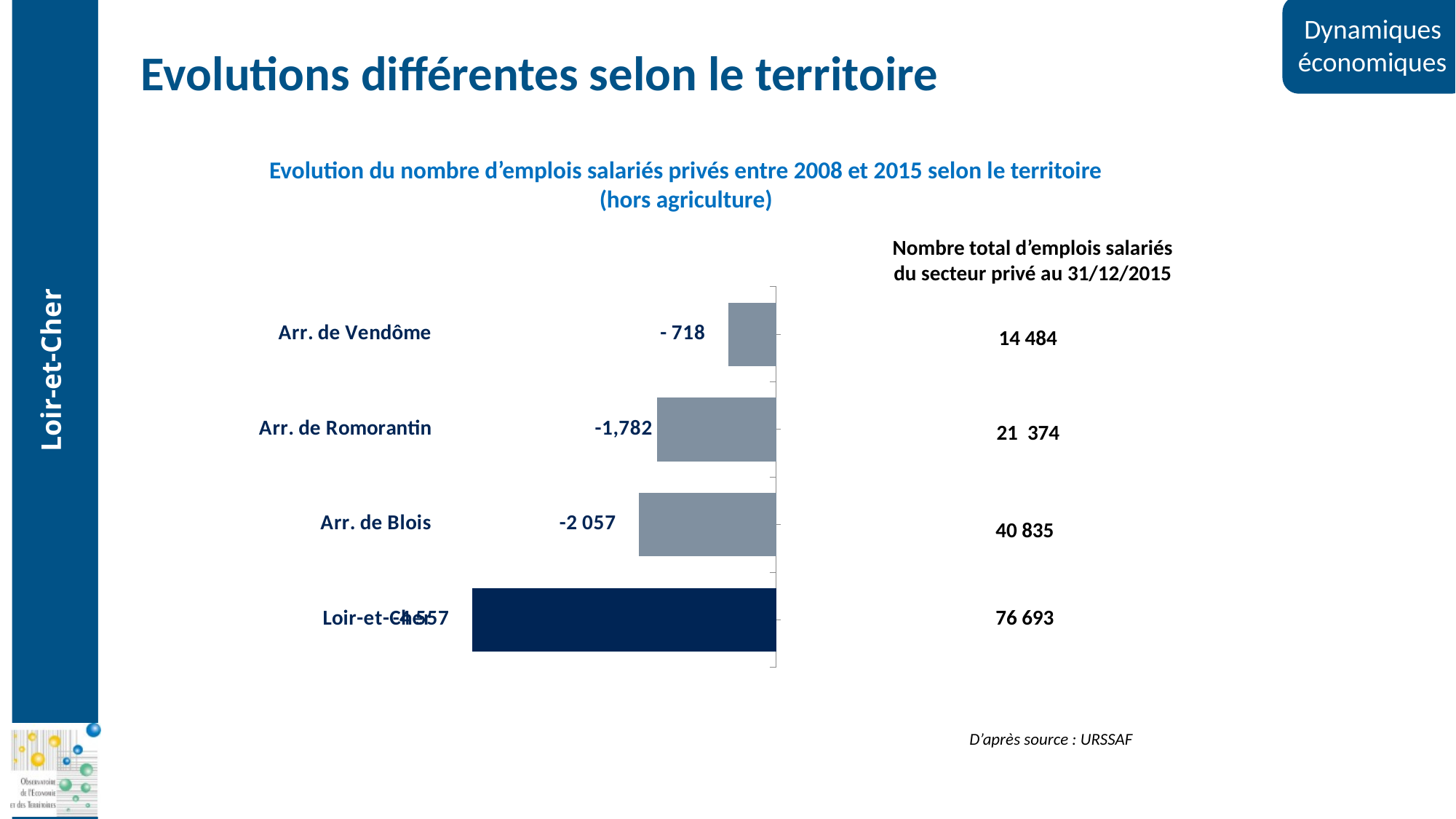
What is the value shown for Arr. de Romorantin? -1,782 By how much does the loss for Arr. de Blois exceed the loss for Arr. de Vendôme in absolute terms? 1 339 Which bar in the chart is coloured dark navy blue rather than grey? Loir-et-Cher What is the title of the chart? Evolution du nombre d'emplois salariés privés entre 2008 et 2015 selon le territoire (hors agriculture) How many categories (territories) are plotted in the chart? 4 Which has the larger (less negative) value, Arr. de Vendôme or Arr. de Blois? Arr. de Vendôme Which territory has the lowest (most negative) value in the chart? Loir-et-Cher Which territory has the highest (least negative) value in the chart? Arr. de Vendôme Which has the larger (less negative) value, Arr. de Blois or Arr. de Romorantin? Arr. de Romorantin What kind of chart is shown on the slide? Bar chart What is the value shown for Arr. de Vendôme? - 718 What is the value shown for Arr. de Blois? -2 057